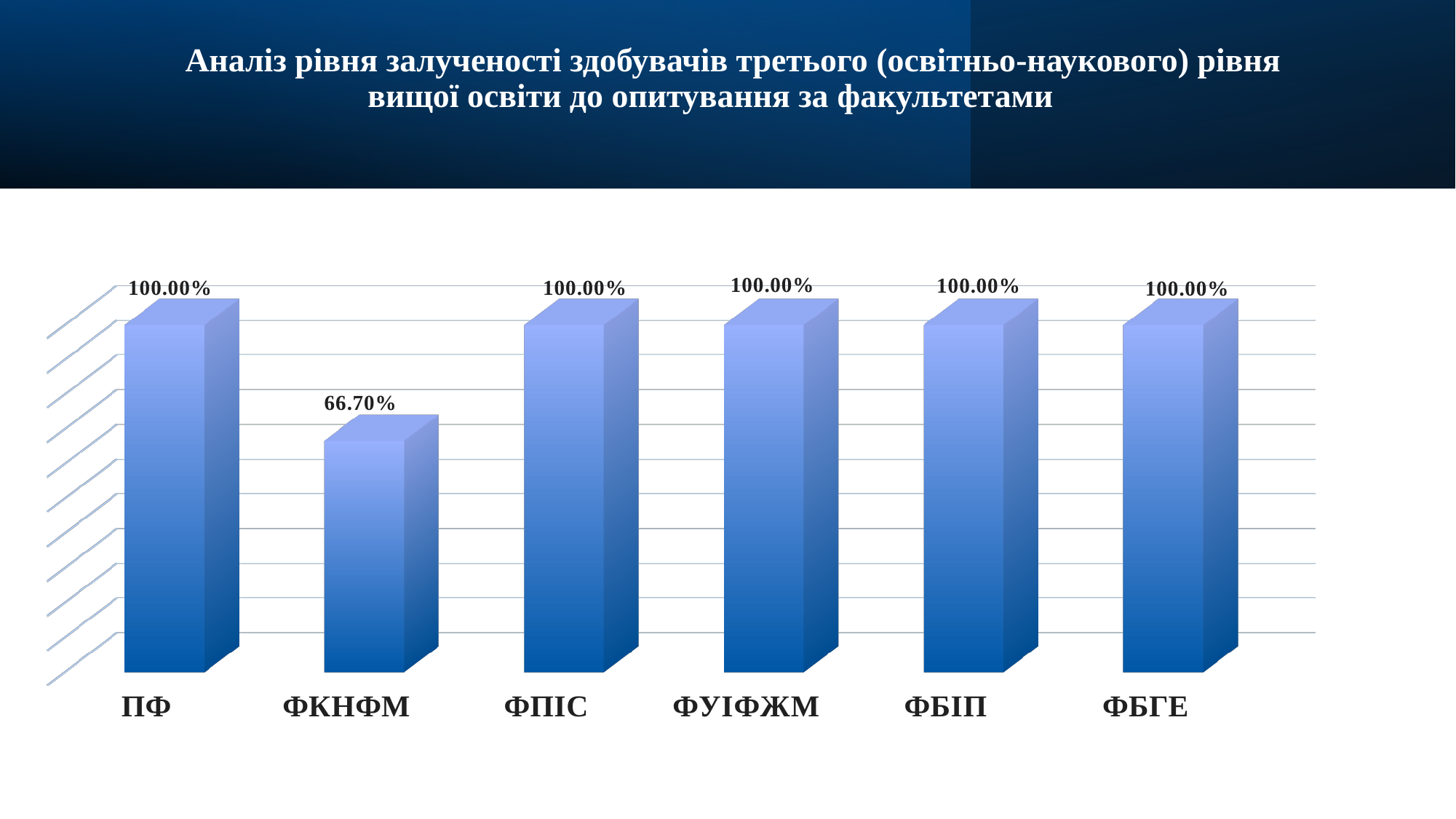
How many faculties have a value of 100.00%? 5 What is the value for ФБГЕ? 100.00% What is the title of the slide? Аналіз рівня залученості здобувачів третього (освітньо-наукового) рівня вищої освіти до опитування за факультетами Which is larger, the value for ФКНФМ or the value for ФБІП? ФБІП What is the value for ФПІС? 100.00% What kind of chart is shown on the slide? Bar chart What is the value for ФУІФЖМ? 100.00% What is the value for ПФ? 100.00% Which faculty has the lowest value? ФКНФМ How many faculties are shown on the chart? 6 What is the value for ФКНФМ? 66.70% What is the difference between the values for ПФ and ФКНФМ? 33.30%